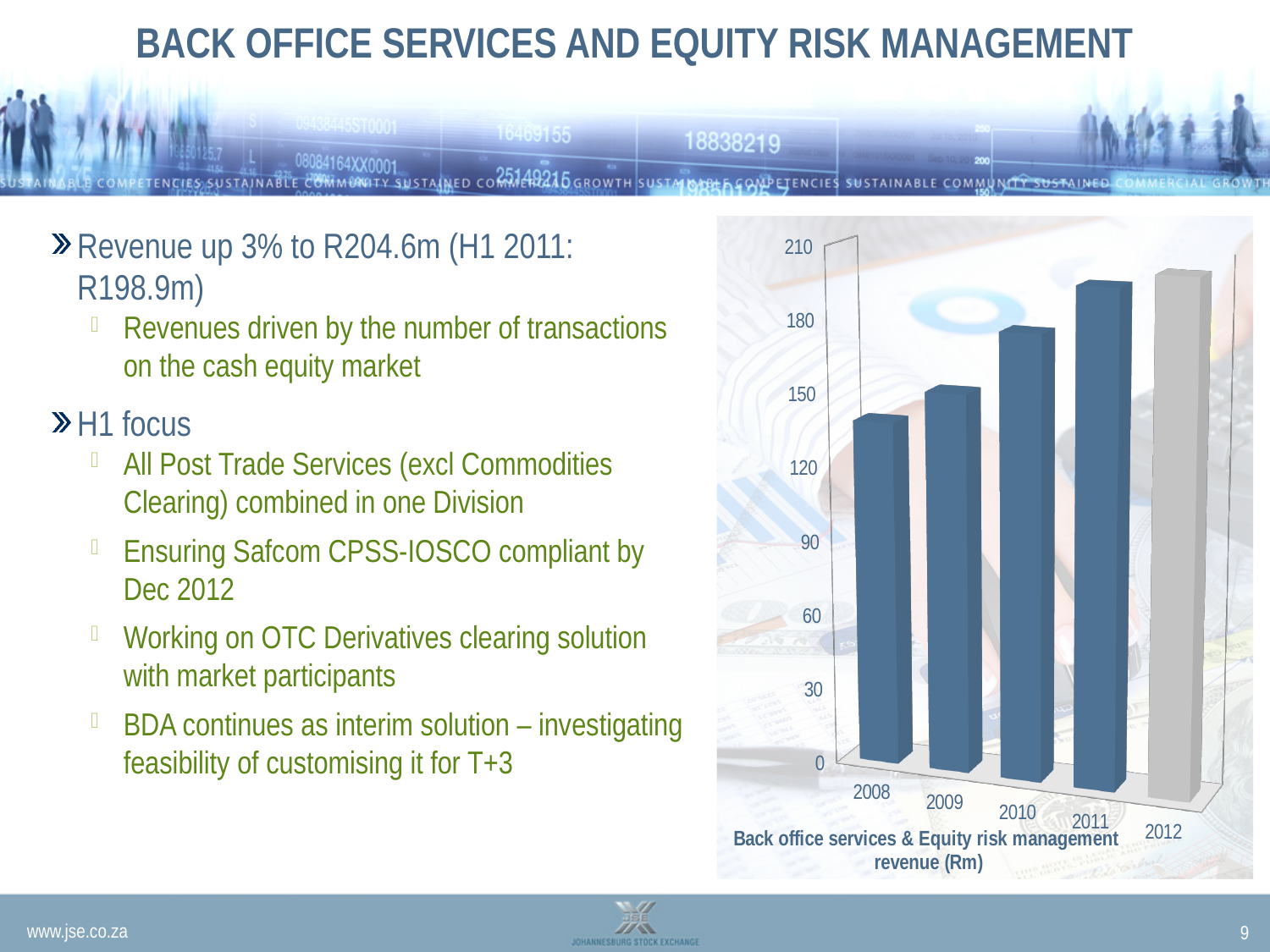
Which year has the highest back office services & equity risk management revenue? 2012 Is the revenue for 2010 greater or less than 150? greater Which year has the lowest back office services & equity risk management revenue? 2008 Which year has the larger revenue, 2009 or 2011? 2011 Is the revenue for 2008 greater or less than 150? less Is the revenue for 2008 greater or less than 120? greater Do the revenue values rise or fall from 2008 to 2012? Rise What kind of chart is shown on the slide? Bar chart What is the title of the chart? Back office services & Equity risk management revenue (Rm) How many years are plotted on the chart? 5